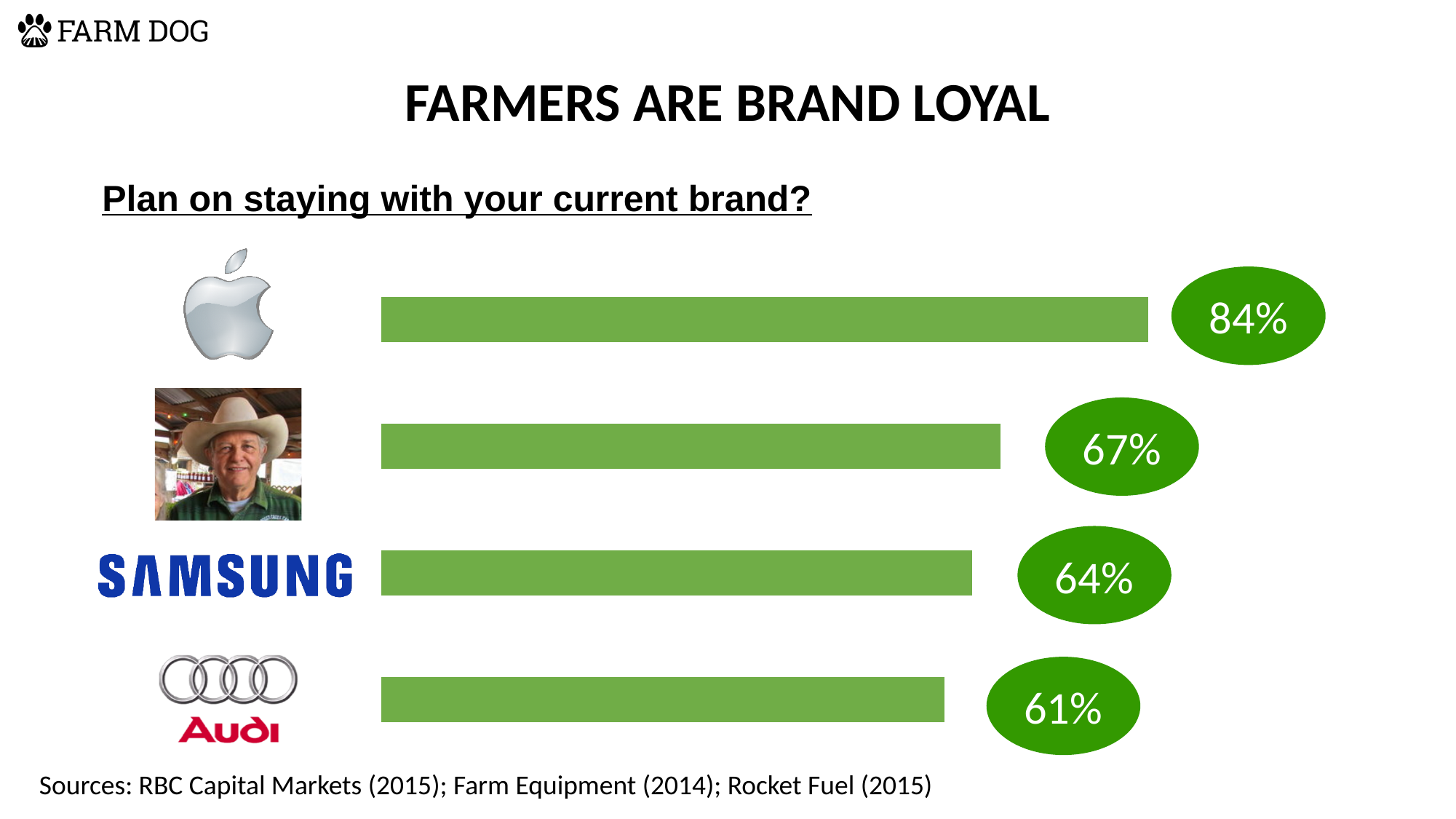
Which brand has the lowest percentage planning to stay with their current brand? Audi What is the difference between the Samsung value and the Audi value? 3% Which brand has the highest percentage planning to stay with their current brand? Apple What is the difference between the Apple value and the Audi value? 23% What kind of chart is shown on the slide? Bar chart How many bars are shown in the chart? 4 What value is shown for the second bar, the one with the farmer photo? 67% Which is larger, the value for Samsung or the value for Audi? Samsung What question is the chart answering, as written above the bars? Plan on staying with your current brand? What percentage of Apple customers plan on staying with their current brand? 84% What value is shown for Audi? 61% What value is shown for Samsung? 64%